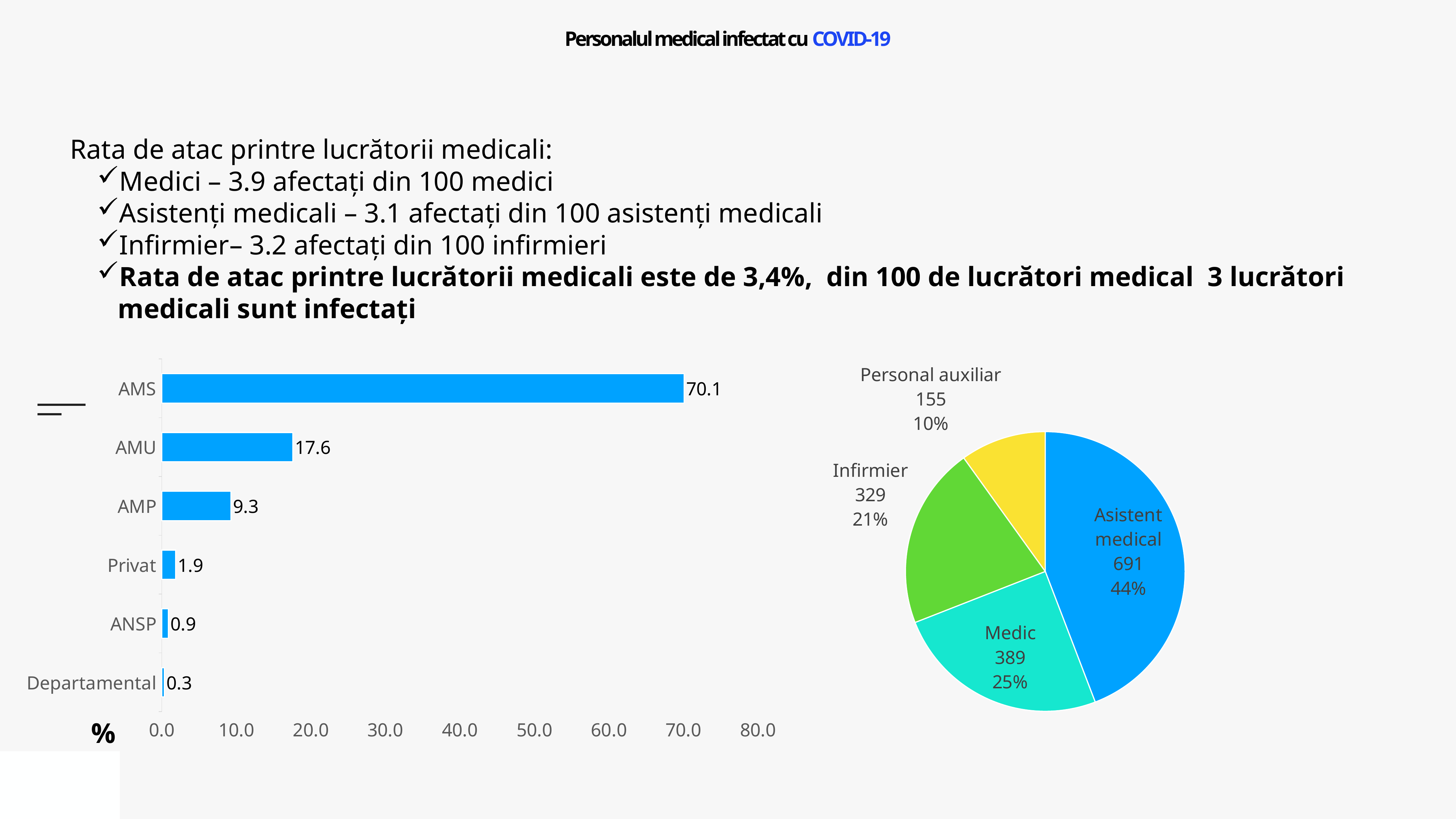
In the bar chart on the left, which is larger, the value for Privat or the value for ANSP? Privat In the bar chart on the left, which category has the lowest value? Departamental In the pie chart on the right, what share of the pie does Infirmier represent? 21% In the bar chart on the left, which category has the highest value? AMS In the pie chart on the right, how many infected Medic are shown? 389 In the pie chart on the right, which category has the smallest slice? Personal auxiliar In the bar chart on the left, what is the difference between the values for AMS and AMU? 52.5 In the pie chart on the right, how many slices are there? 4 In the bar chart on the left, how many categories are shown? 6 In the bar chart on the left, what is the value for AMS? 70.1 In the bar chart on the left, what is the value for AMP? 9.3 What kind of chart is the chart on the left of the slide? Bar chart